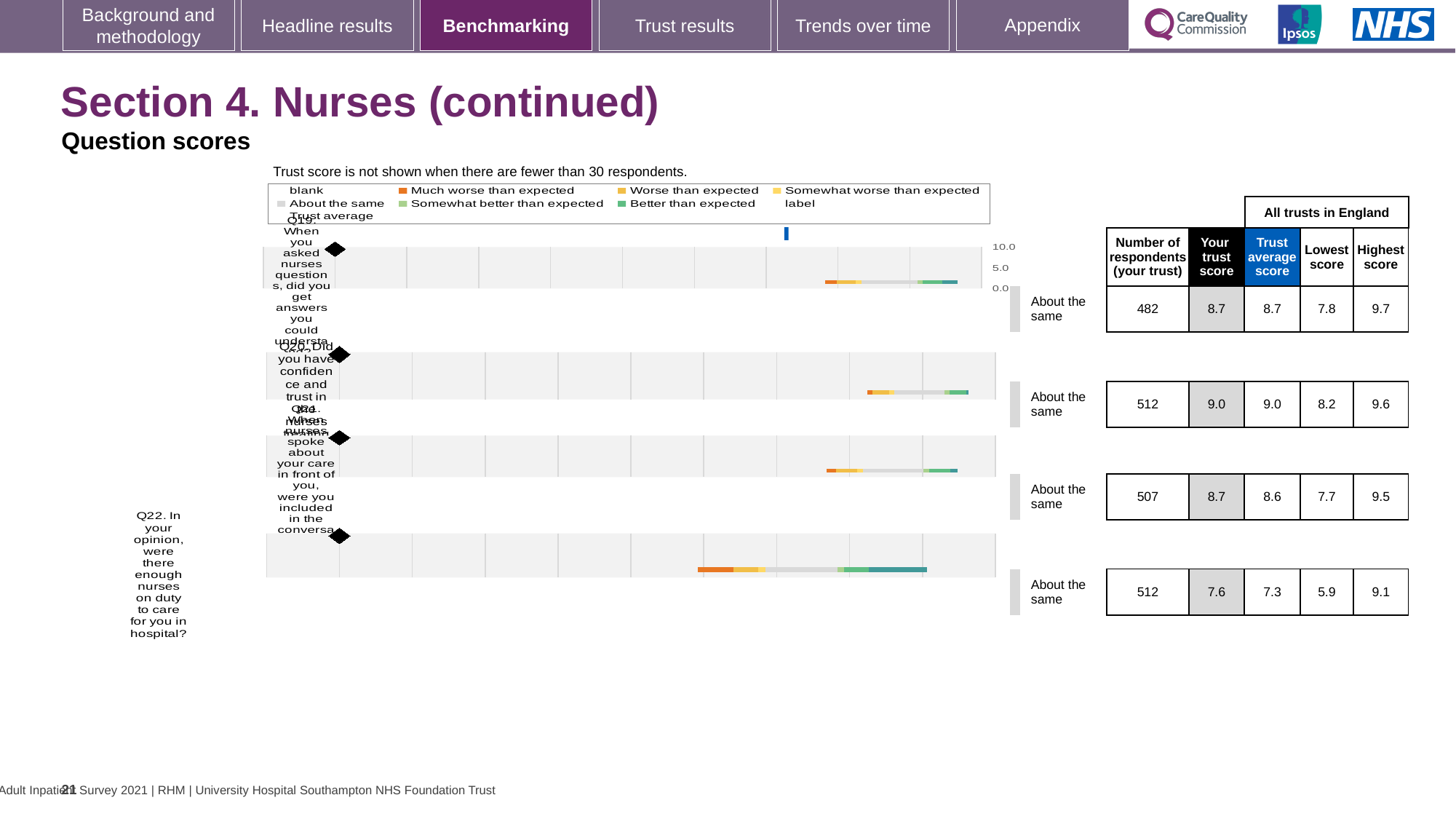
Which question has the lowest 'Lowest score' among all trusts in England? Q22 For Q22, what is the difference between the highest score and the lowest score across all trusts in England? 3.2 What is the highest score across all trusts in England for Q19? 9.7 For Q22, what is the difference between 'Your trust score' and the trust average score? 0.3 How many respondents (your trust) are shown for Q19? 482 What is the 'Your trust score' for Q22 (were there enough nurses on duty to care for you in hospital)? 7.6 What kind of chart is used to show the question scores? Bar chart How many questions are plotted on the chart? 4 Is the trust score for Q22 greater or less than 5.0? greater Which question has the highest 'Your trust score'? Q20 What is the trust average score for Q21 (when nurses spoke about your care in front of you, were you included in the conversation)? 8.6 For Q21, which is larger: 'Your trust score' or the trust average score? Your trust score